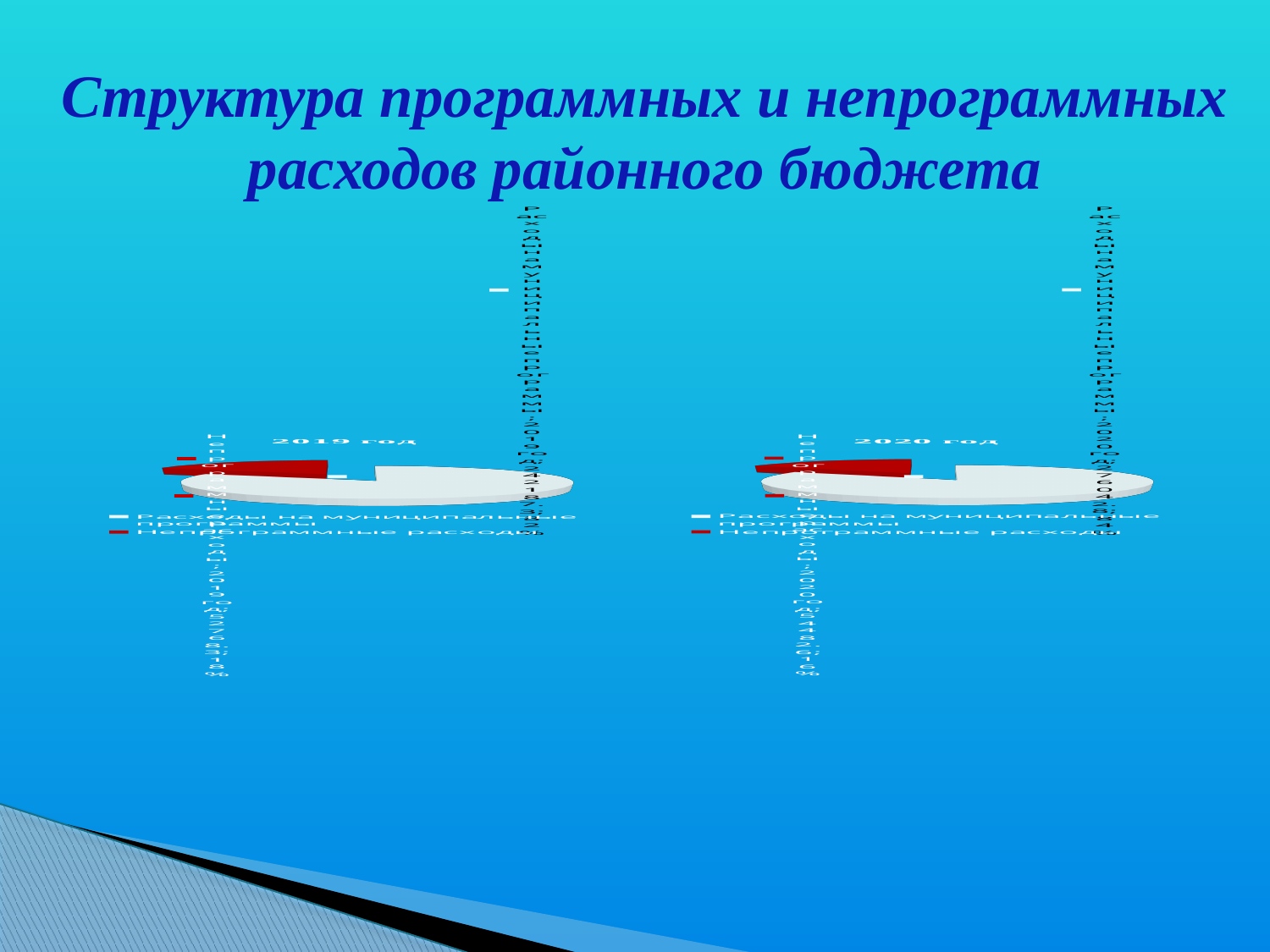
How many slices does the left chart ("2019 год") have? 2 How many entries does the legend of the left chart ("2019 год") list? 2 In the right chart ("2020 год"), which category has the smaller slice? Непрограммные расходы In the left chart ("2019 год"), which category has the larger slice: "Расходы на муниципальные программы" or "Непрограммные расходы"? Расходы на муниципальные программы How many entries does the legend of the right chart ("2020 год") list? 2 In the left chart ("2019 год"), which category has the largest slice? Расходы на муниципальные программы What kind of chart is the right chart titled "2020 год"? pie chart How many slices does the right chart ("2020 год") have? 2 In the right chart ("2020 год"), what colour is the slice for "Непрограммные расходы"? red What is the title of the left chart? 2019 год What kind of chart is the left chart titled "2019 год"? pie chart